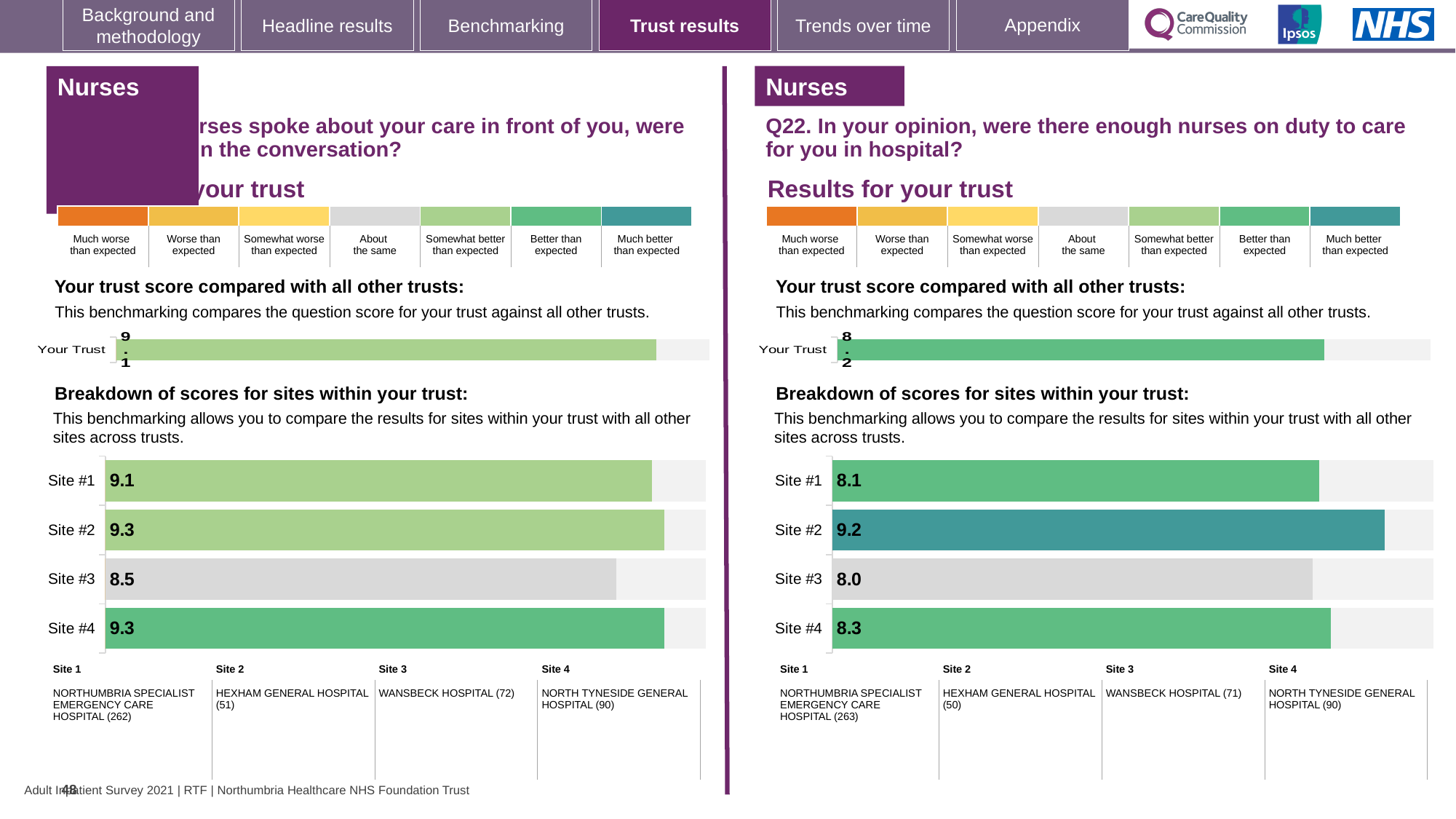
On the left-hand site breakdown chart, what is the score for Site #3? 8.5 On the right-hand (Q22) site breakdown chart, what is the score for Site #2? 9.2 On the left-hand 'Your trust score compared with all other trusts' chart, what is the score shown for Your Trust? 9.1 On the right-hand (Q22) site breakdown chart, which site has the highest score? Site #2 On the left-hand site breakdown chart, which site has the lowest score? Site #3 On the right-hand (Q22) site breakdown chart, which site has the lowest score? Site #3 On the right-hand (Q22) site breakdown chart, what is the difference between the scores for Site #2 and Site #3? 1.2 How many sites are shown on the left-hand site breakdown chart? 4 On the right-hand (Q22) site breakdown chart, which has the larger score, Site #1 or Site #4? Site #4 On the right-hand (Q22) 'Your trust score compared with all other trusts' chart, what is the score shown for Your Trust? 8.2 On the left-hand site breakdown chart, what is the difference between the scores for Site #2 and Site #3? 0.8 What kind of chart is the right-hand (Q22) site breakdown chart? Bar chart